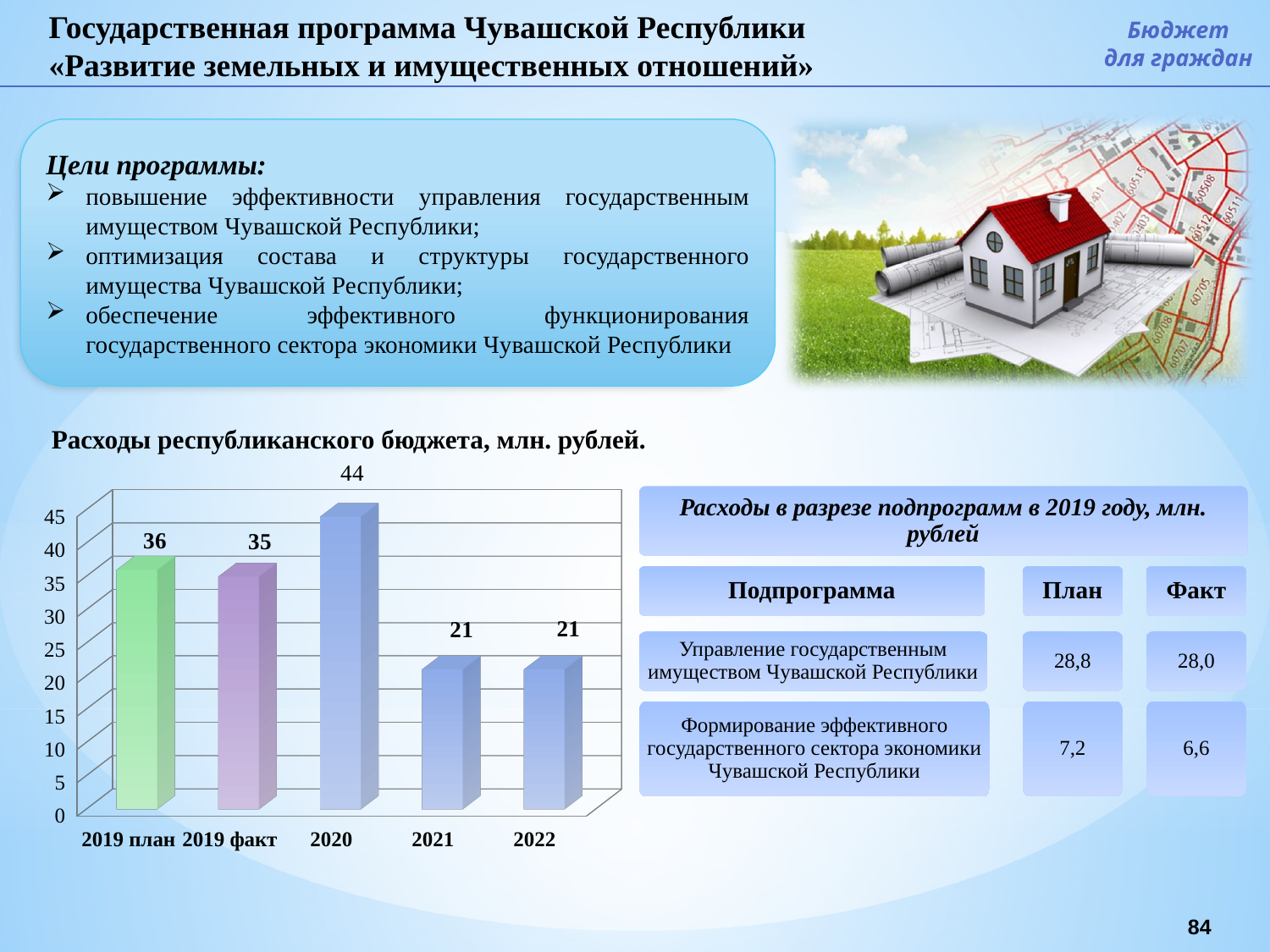
Is the value for 2020 in the bar chart greater or less than 40? greater Which category has the highest value in the bar chart? 2020 What is the value for 2020 in the bar chart? 44 Which is larger in the bar chart, the value for 2019 план or the value for 2022? 2019 план What is the value for 2021 in the bar chart? 21 What is the difference between the values for 2019 план and 2021 in the bar chart? 15 How many categories are shown on the x axis of the bar chart? 5 What is the title above the bar chart? Расходы республиканского бюджета, млн. рублей. What is the value for 2019 план in the bar chart? 36 What is the value for 2019 факт in the bar chart? 35 What is the difference between the values for 2020 and 2019 факт in the bar chart? 9 What kind of chart is shown on the slide? bar chart